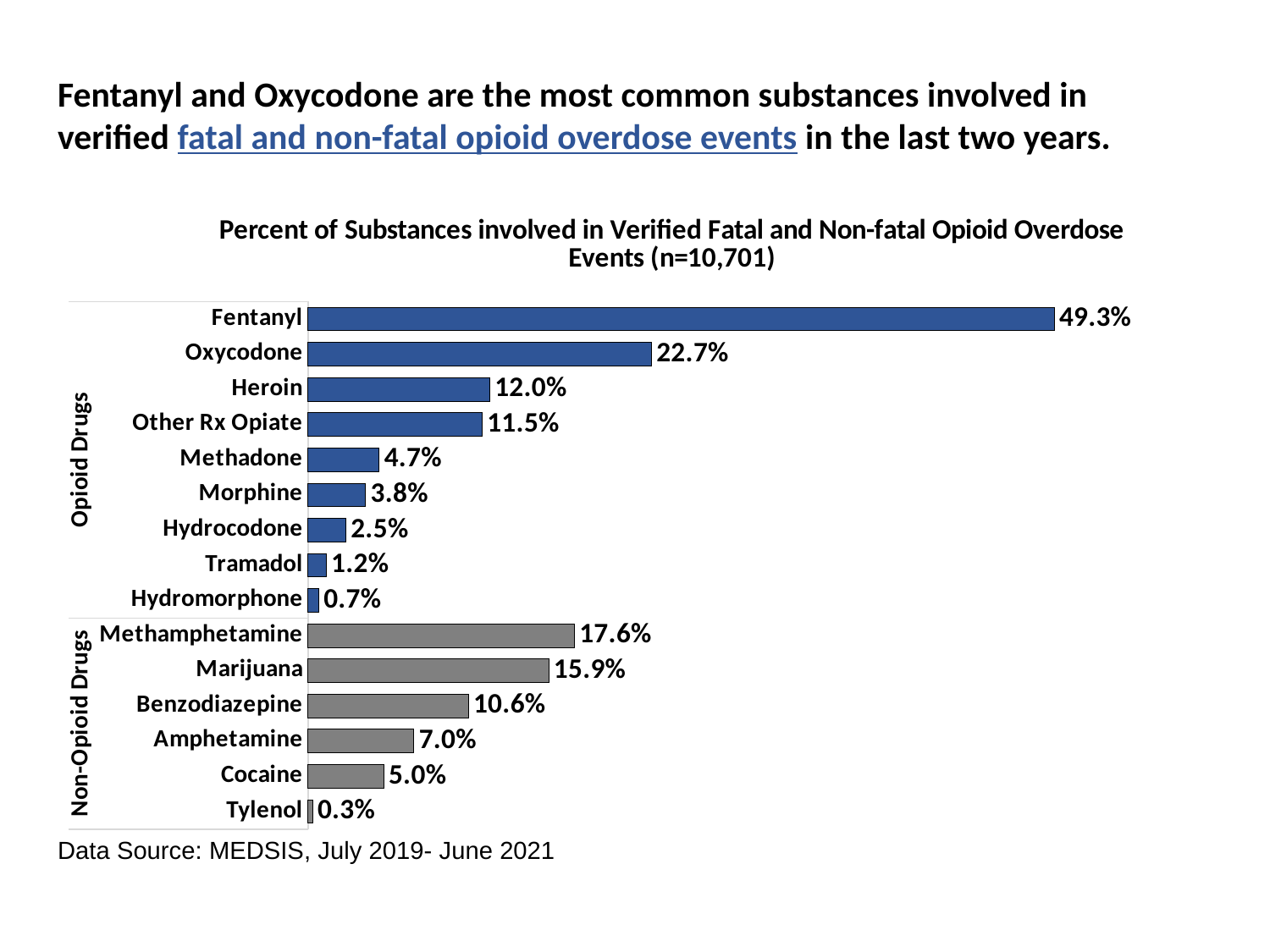
Which substance has the highest percentage in the chart? Fentanyl What is the difference between the percentages for Methamphetamine and Marijuana? 1.7% What type of chart is shown on the slide? Bar chart Which non-opioid drug has the highest percentage? Methamphetamine What is the difference between the percentages for Fentanyl and Oxycodone? 26.6% How many substances are listed in the chart? 15 Which substance has the lowest percentage in the chart? Tylenol What is the value shown for Methamphetamine? 17.6% What are the two groups into which the substances are divided on the chart's axis? Opioid Drugs and Non-Opioid Drugs What percent is shown for Benzodiazepine? 10.6% What percent of verified opioid overdose events involved Fentanyl? 49.3% Which has a higher percentage, Heroin or Methamphetamine? Methamphetamine